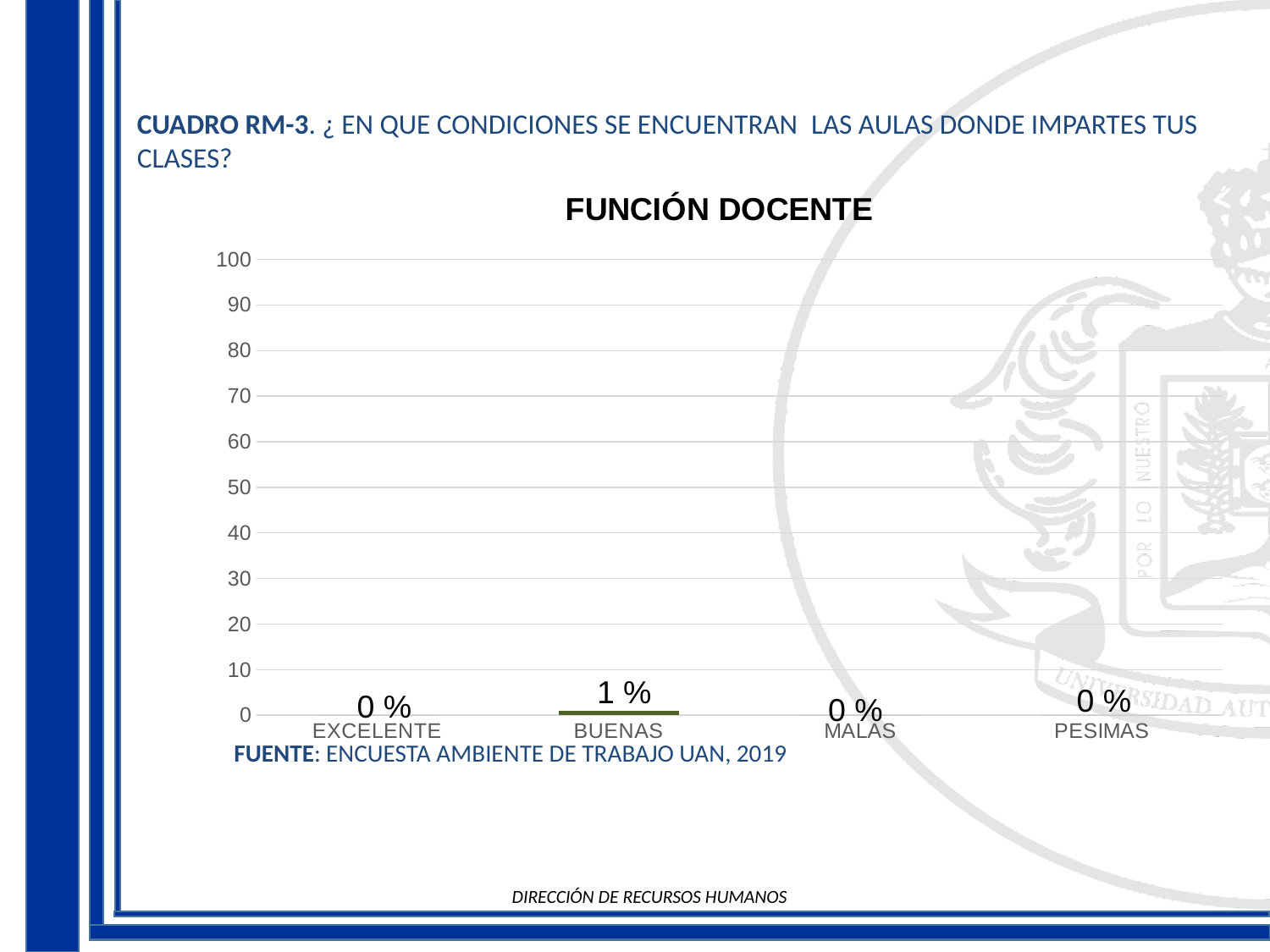
What is the value for EXCELENTE? 0 % How many categories are shown on the x axis? 4 Is the value for BUENAS greater or less than 10? less What is the value for BUENAS? 1 % What is the highest value shown on the y axis? 100 Which is larger, the value for BUENAS or the value for MALAS? BUENAS What is the value for MALAS? 0 % What is the value for PESIMAS? 0 % Which category has the highest value? BUENAS What is the difference between the values for BUENAS and EXCELENTE? 1 % What is the title of the chart? FUNCIÓN DOCENTE What kind of chart is shown on the slide? bar chart